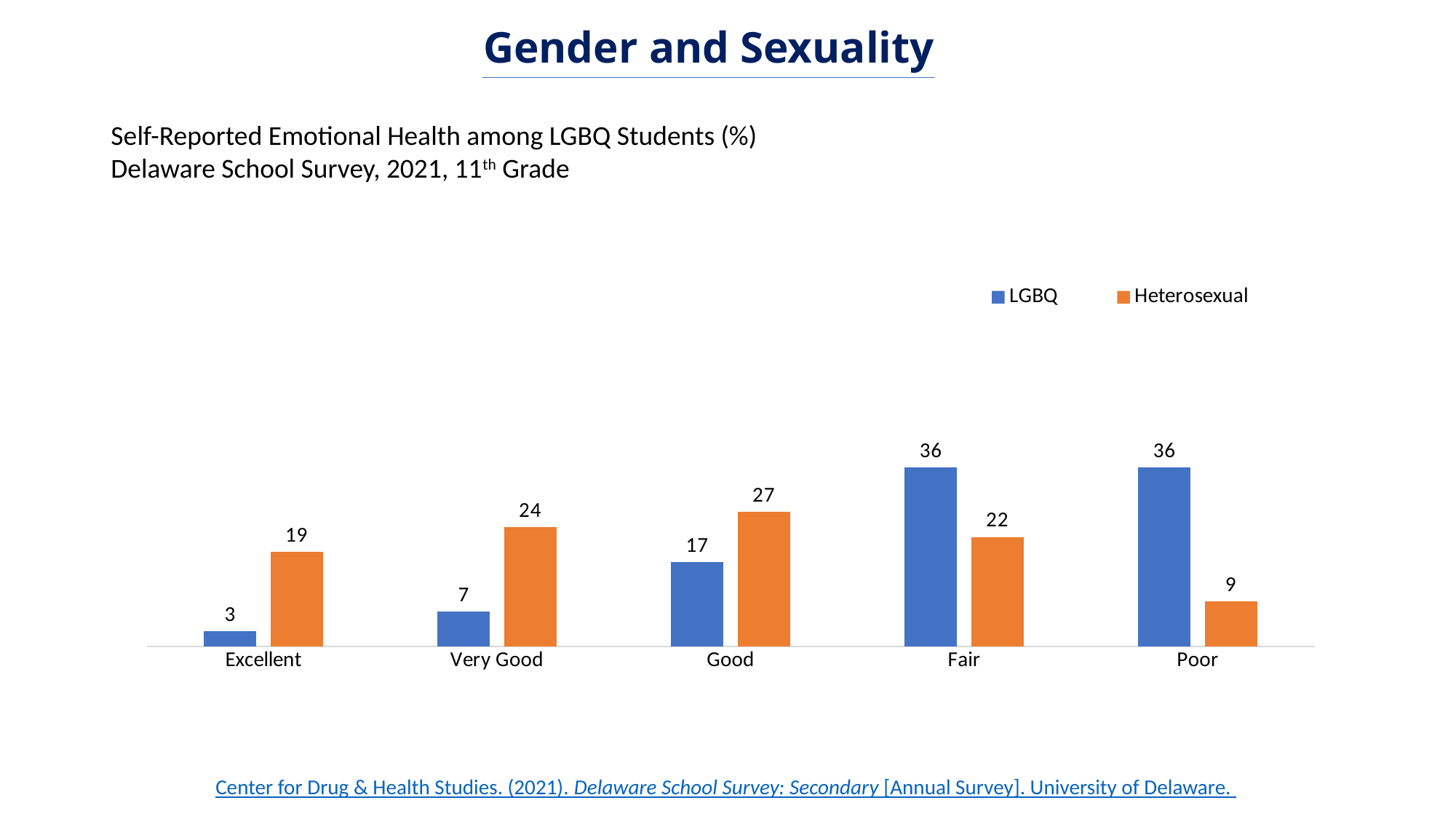
How many series does the legend list? 2 Which colour represents the Heterosexual series? Orange Which category has the highest Heterosexual value? Good What is the LGBQ value for Excellent? 3 What kind of chart is shown on the slide? Bar chart What is the Heterosexual value for Good? 27 What is the difference between the LGBQ and Heterosexual values for Poor? 27 How many categories are shown on the x axis? 5 Which category has the lowest LGBQ value? Excellent What is the LGBQ value for Poor? 36 Which is larger for Very Good, the LGBQ value or the Heterosexual value? Heterosexual Which category has the lowest Heterosexual value? Poor